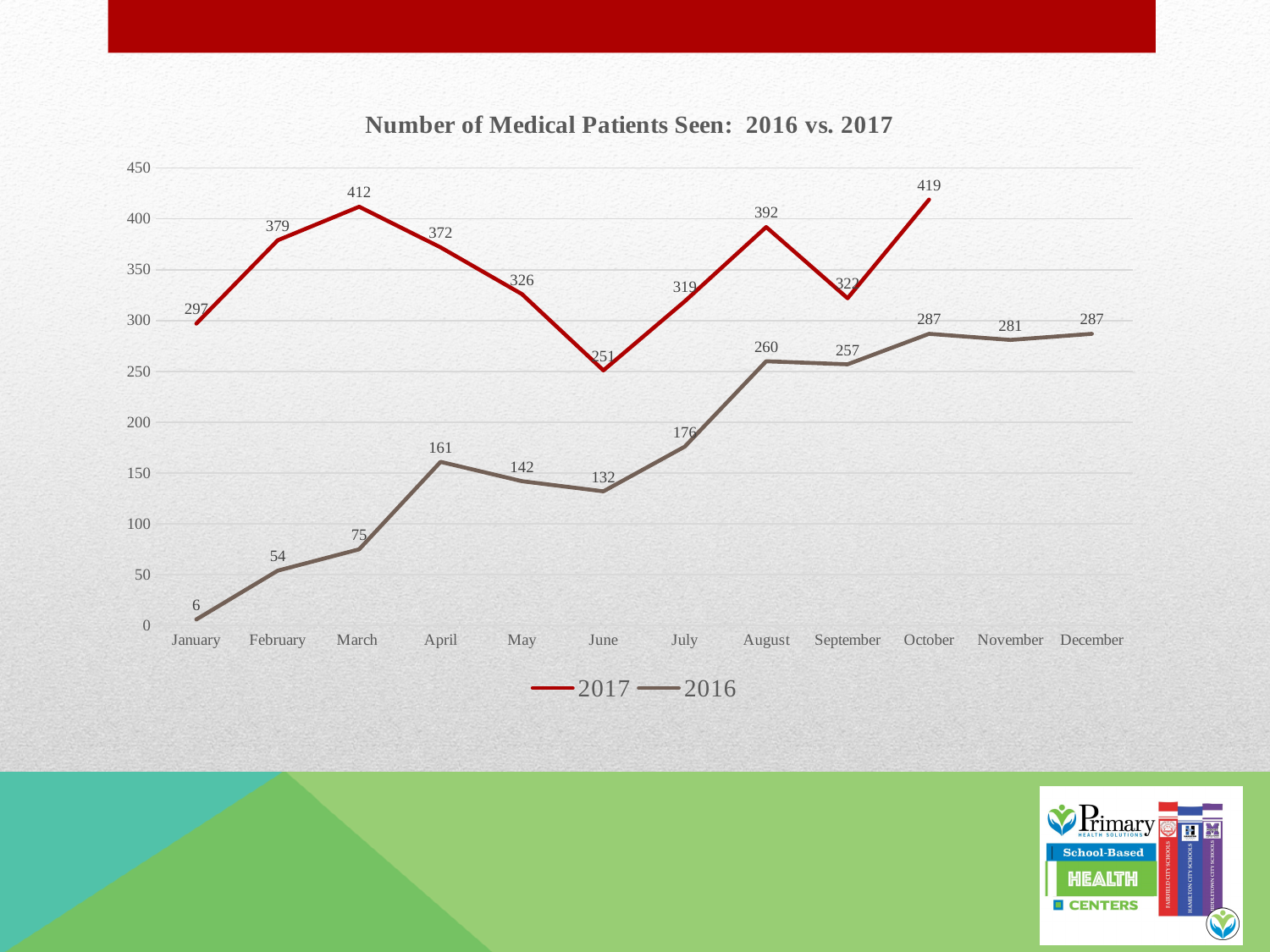
What is the value for 2016 in August? 260 What is the difference between the 2017 and 2016 values in June? 119 What is the title of the chart? Number of Medical Patients Seen: 2016 vs. 2017 In which month is the 2016 value lowest? January How many months are shown on the x axis? 12 What is the value for 2017 in March? 412 What type of chart is shown on the slide? Line chart Which colour is used for the 2017 series? Red Does the 2016 series rise or fall from January to April? Rise Which is larger, the 2016 value in November or the 2016 value in December? December In which month is the 2017 value highest? October How many series does the legend list? 2